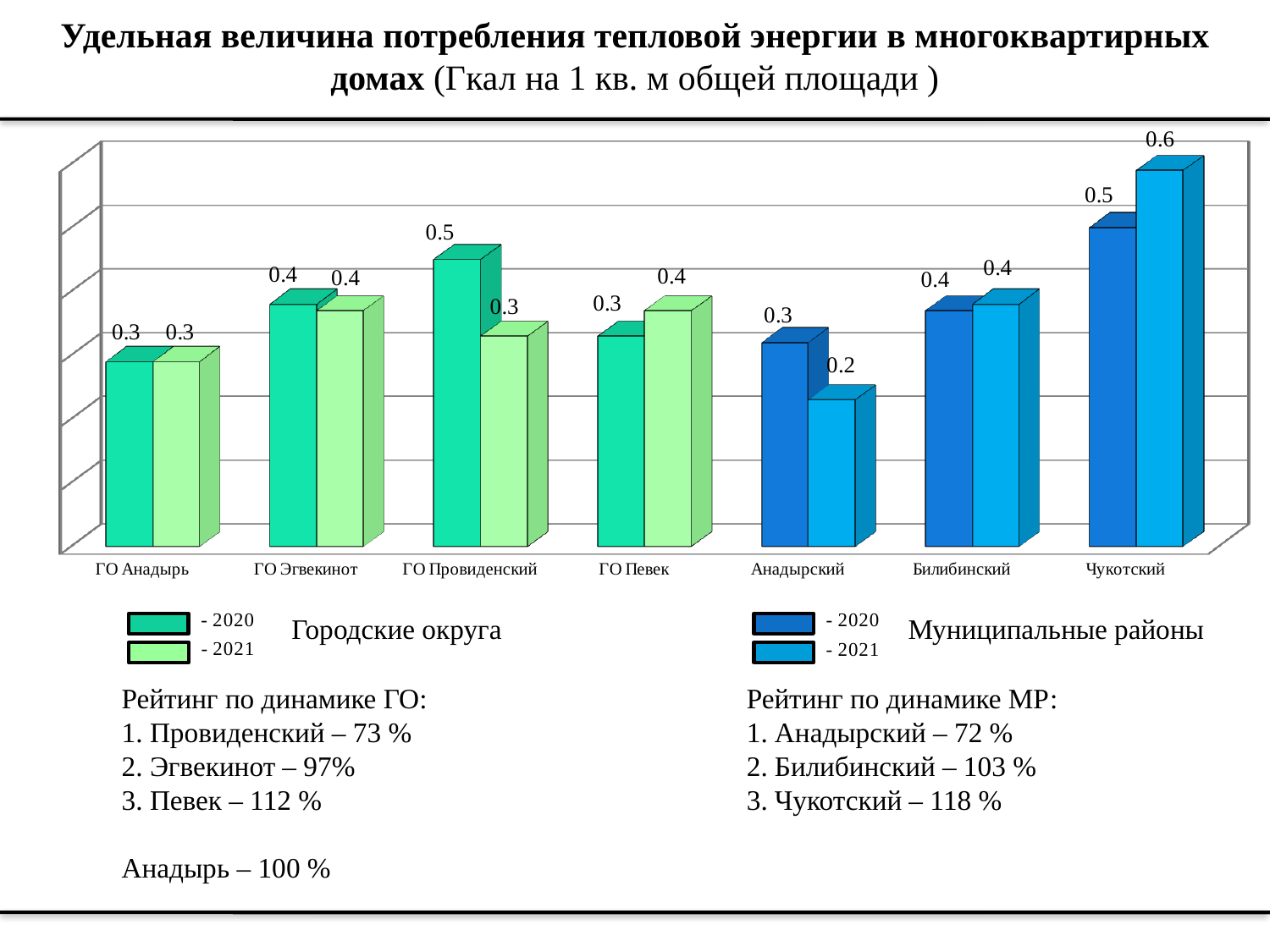
What kind of chart is shown on the slide? Bar chart Which years are listed in the chart legend? 2020 and 2021 How many series does the legend for Городские округа list? 2 Which category has the lowest 2021 value? Анадырский What is the 2021 value for Чукотский? 0.6 What is the difference between the 2020 and 2021 values for ГО Провиденский? 0.2 Which category has the highest 2021 value? Чукотский What is the 2020 value for ГО Певек? 0.3 What is the 2020 value for ГО Провиденский? 0.5 How many categories are shown on the x axis of the chart? 7 Which is larger: the 2021 value for Чукотский or the 2021 value for Анадырский? Чукотский What is the 2021 value for Анадырский? 0.2